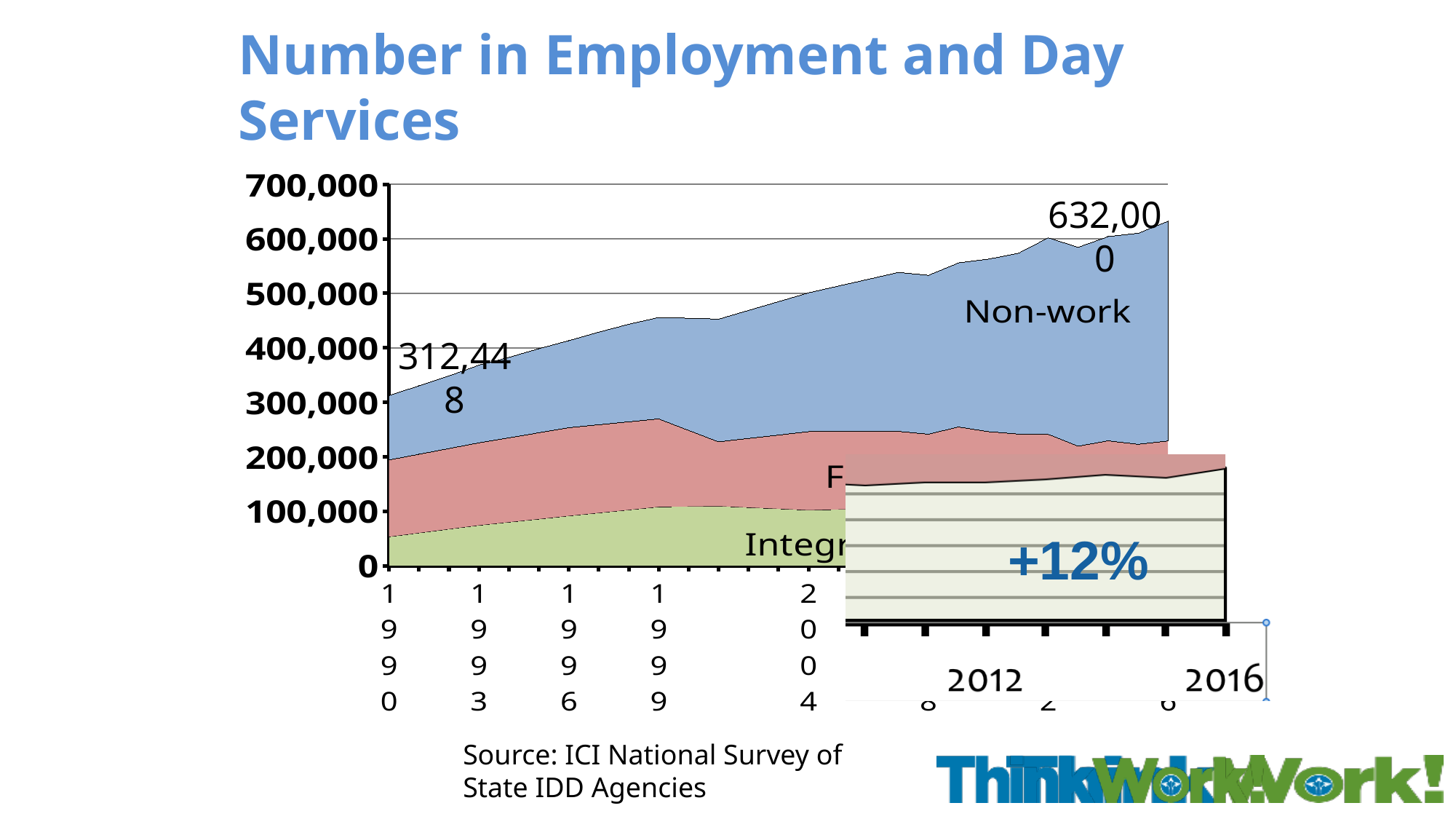
Is the labelled total for 1990 greater or less than 300,000? greater What total value is labelled at the start of the chart, in 1990? 312,448 What kind of chart is shown on the slide? Area chart What is the highest value shown on the vertical axis? 700,000 Is the labelled total for 2016 greater or less than 600,000? greater Does the total number in employment and day services rise or fall from 1990 to 2016? Rise By how much did the labelled total grow from 312,448 in 1990 to 632,000 in 2016? 319,552 What percentage change is shown in the inset box covering 2012 to 2016? +12% Which year has the larger labelled total, 1990 or 2016? 2016 What total value is labelled at the end of the chart, in 2016? 632,000 Is the total value in 1999 greater or less than 500,000? less What is the title of the chart? Number in Employment and Day Services